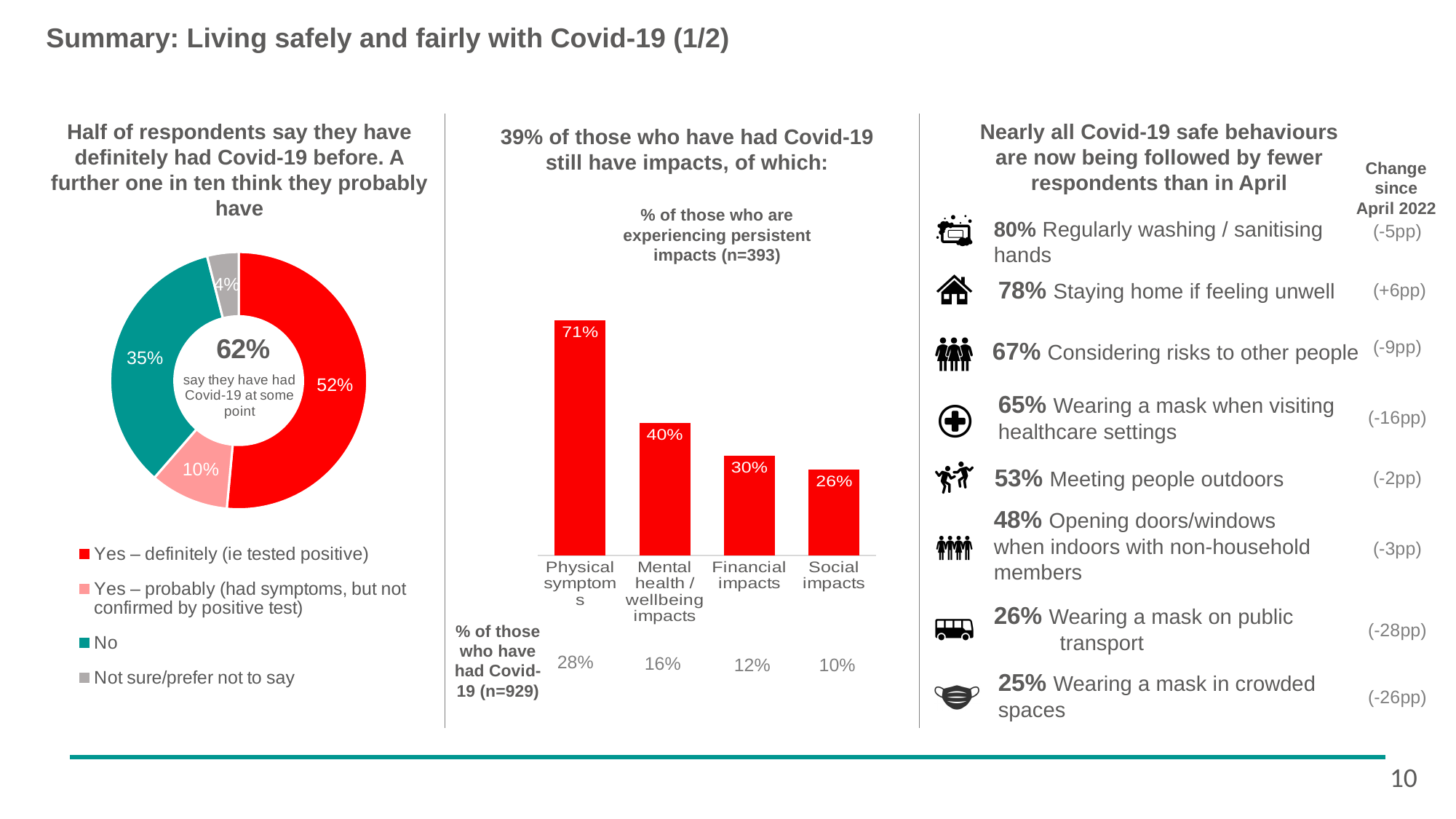
In the bar chart in the middle, how many categories are plotted? 4 In the donut chart on the left, how many categories does the legend list? 4 In the bar chart in the middle, which category has the highest value? Physical symptoms What type of chart is shown on the left of the slide? Donut (pie) chart In the donut chart on the left, which response has the smallest share? Not sure/prefer not to say In the donut chart on the left, what percentage of respondents say 'Yes – definitely (ie tested positive)'? 52% In the bar chart in the middle, what is the difference between 'Physical symptoms' and 'Financial impacts'? 41% In the donut chart on the left, what percentage of respondents answered 'No'? 35% In the bar chart in the middle, which category has the lowest value? Social impacts In the bar chart in the middle, what is the value for 'Mental health / wellbeing impacts'? 40% In the bar chart in the middle, do the values rise or fall from left to right across the categories? Fall In the donut chart on the left, what is the difference between the 'Yes – definitely' share and the 'No' share? 17%